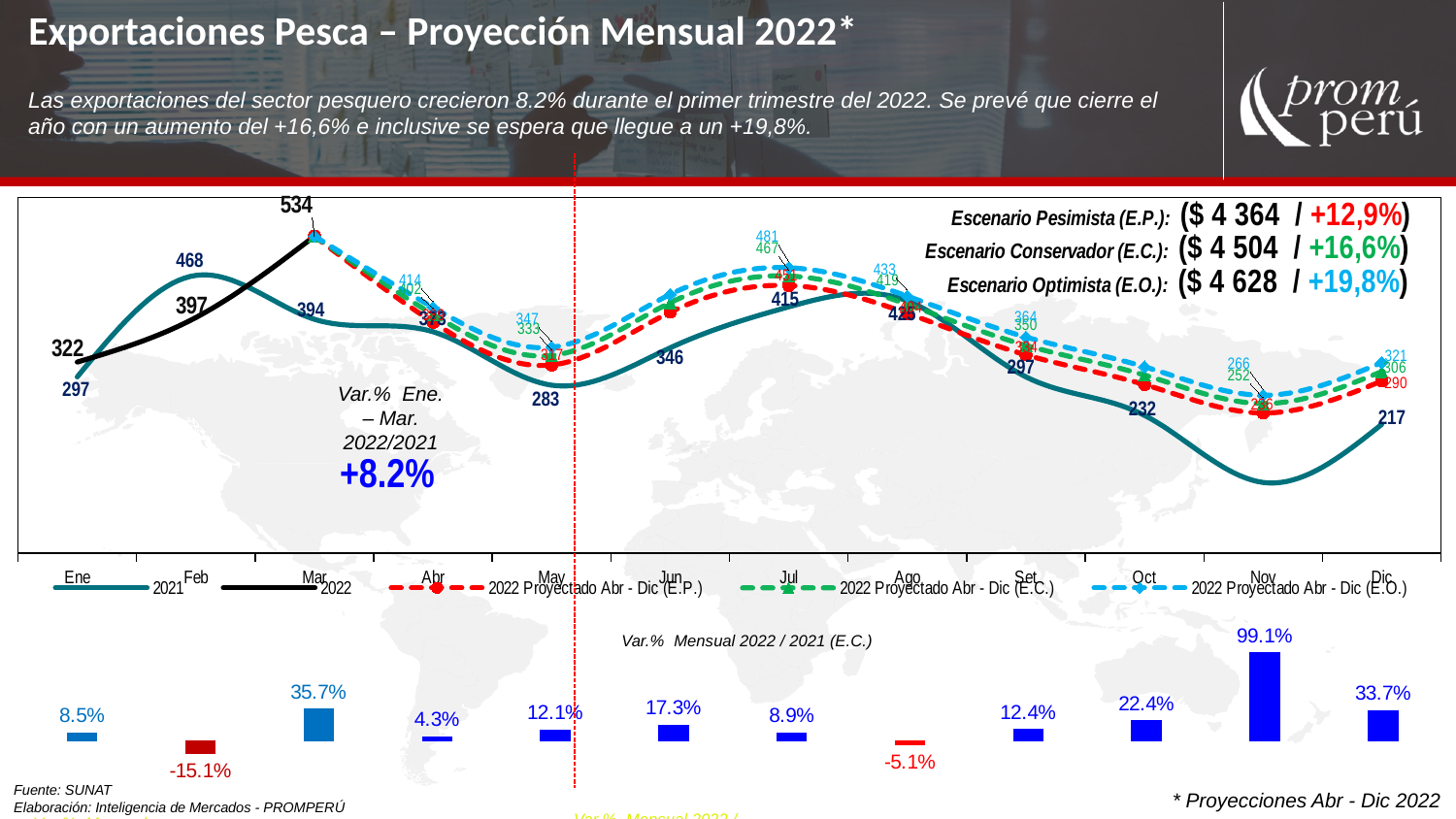
In the bottom bar chart (Var.% Mensual 2022 / 2021 (E.C.)), which month has the lowest value? Feb In the top line chart, what is the difference between the 2022 and 2021 values for Ene? 25 In the bottom bar chart (Var.% Mensual 2022 / 2021 (E.C.)), how many months are plotted? 12 What annual total and growth are shown for the Escenario Optimista (E.O.)? $ 4 628 / +19,8% How many series does the legend of the top line chart list? 5 In the top line chart, what is the 2022 value for Mar? 534 In the bottom bar chart (Var.% Mensual 2022 / 2021 (E.C.)), what is the value for Nov? 99.1% In the bottom bar chart (Var.% Mensual 2022 / 2021 (E.C.)), which month has the highest value? Nov In the top line chart, which is larger for Mar: the 2021 value or the 2022 value? 2022 In the bottom bar chart (Var.% Mensual 2022 / 2021 (E.C.)), what is the value for Ago? -5.1% In the bottom bar chart (Var.% Mensual 2022 / 2021 (E.C.)), what is the difference between the Mar value and the Ene value? 27.2 percentage points In the top line chart, what is the 2021 value for Feb? 468